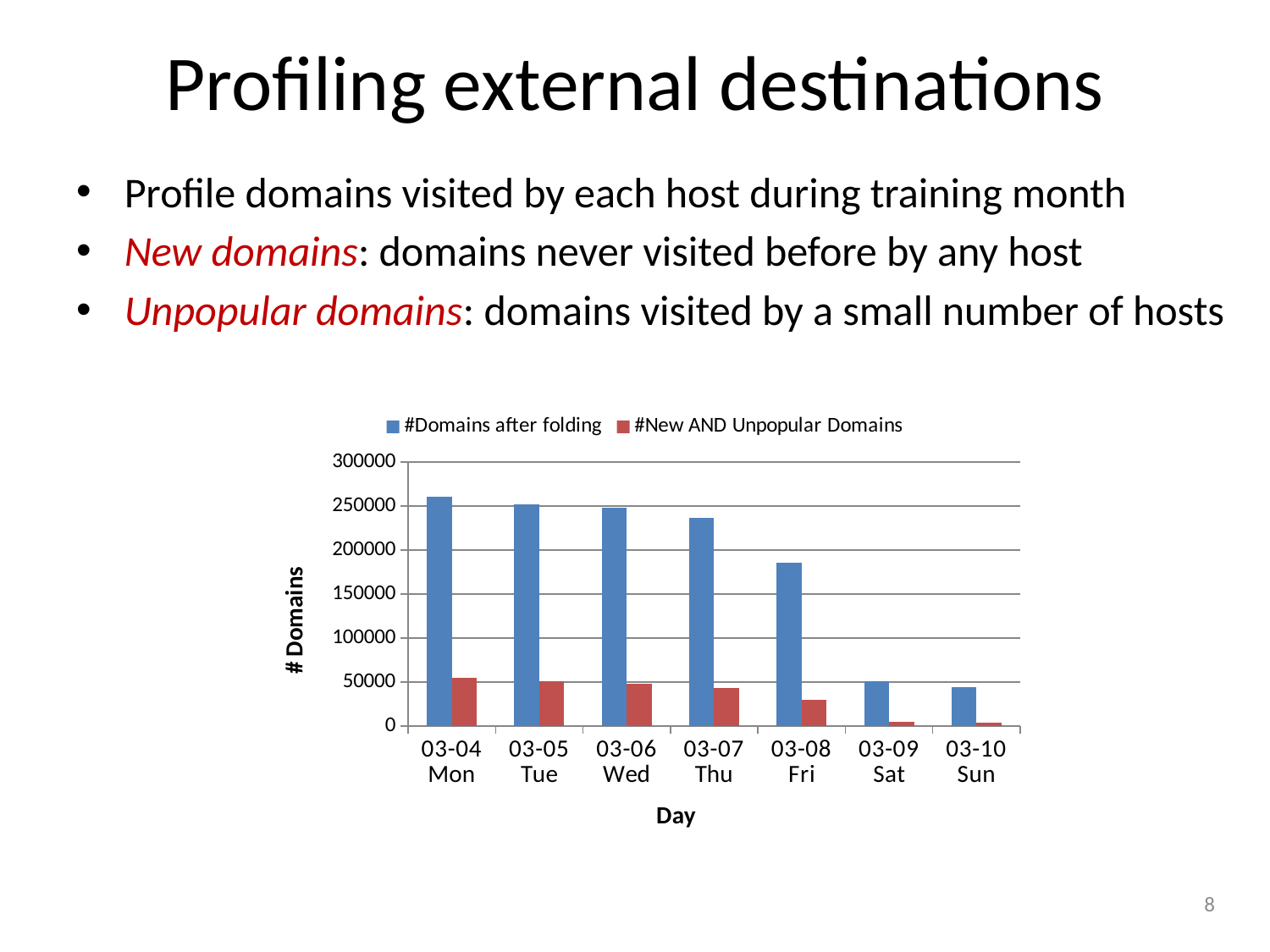
Which is larger on 03-08 Fri: #Domains after folding or #New AND Unpopular Domains? #Domains after folding Is the value for #Domains after folding on 03-08 Fri greater or less than 150000? greater How many days are shown on the x axis? 7 Is the value for #Domains after folding on 03-09 Sat greater or less than 100000? less Is the value for #Domains after folding on 03-04 Mon greater or less than 250000? greater How many series does the legend list? 2 Which day has the lowest value for #Domains after folding? 03-10 Sun What is the label of the y axis? # Domains Do the values for #Domains after folding rise or fall from 03-04 Mon to 03-10 Sun? fall What kind of chart is shown on the slide? bar chart Which day has the highest value for #Domains after folding? 03-04 Mon